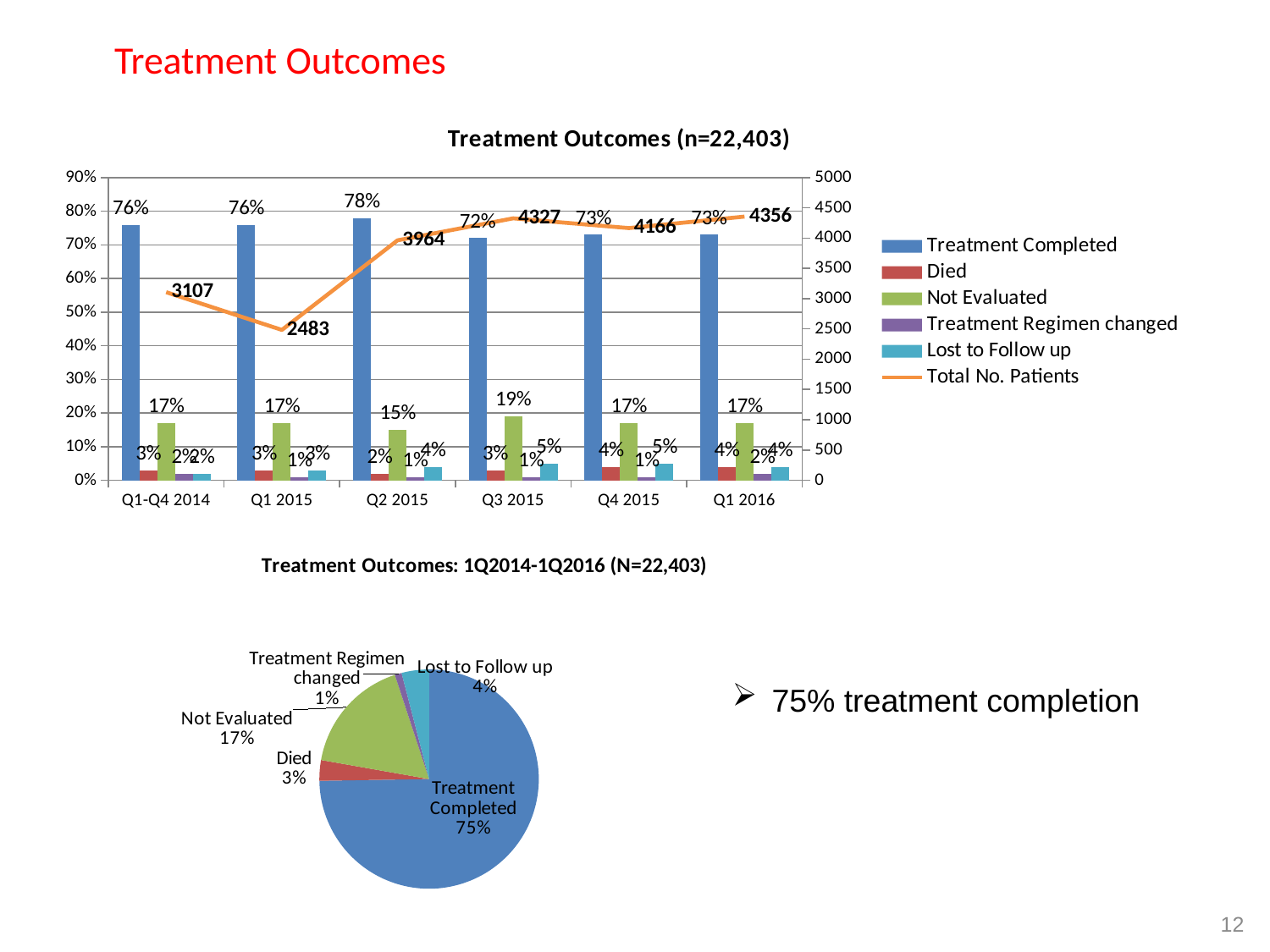
In the top chart 'Treatment Outcomes (n=22,403)', does the Total No. Patients line rise or fall from Q1 2015 to Q3 2015? rise In the top chart 'Treatment Outcomes (n=22,403)', which quarter has the highest Total No. Patients? Q1 2016 In the top chart 'Treatment Outcomes (n=22,403)', what is the Total No. Patients value for Q1 2015? 2483 In the top chart 'Treatment Outcomes (n=22,403)', what is the difference in Total No. Patients between Q3 2015 and Q1 2015? 1844 How many quarter categories are shown on the x axis of the top chart 'Treatment Outcomes (n=22,403)'? 6 In the bottom pie chart 'Treatment Outcomes: 1Q2014-1Q2016 (N=22,403)', what share does Not Evaluated have? 17% In the top chart 'Treatment Outcomes (n=22,403)', what is the Not Evaluated percentage for Q3 2015? 19% How many series does the legend of the top chart 'Treatment Outcomes (n=22,403)' list? 6 What kind of chart is the bottom chart 'Treatment Outcomes: 1Q2014-1Q2016 (N=22,403)'? pie chart In the top chart 'Treatment Outcomes (n=22,403)', what is the Treatment Completed percentage for Q2 2015? 78% In the top chart 'Treatment Outcomes (n=22,403)', which quarter has the lowest Total No. Patients? Q1 2015 In the top chart 'Treatment Outcomes (n=22,403)', which quarter has a higher Treatment Completed percentage, Q1-Q4 2014 or Q3 2015? Q1-Q4 2014